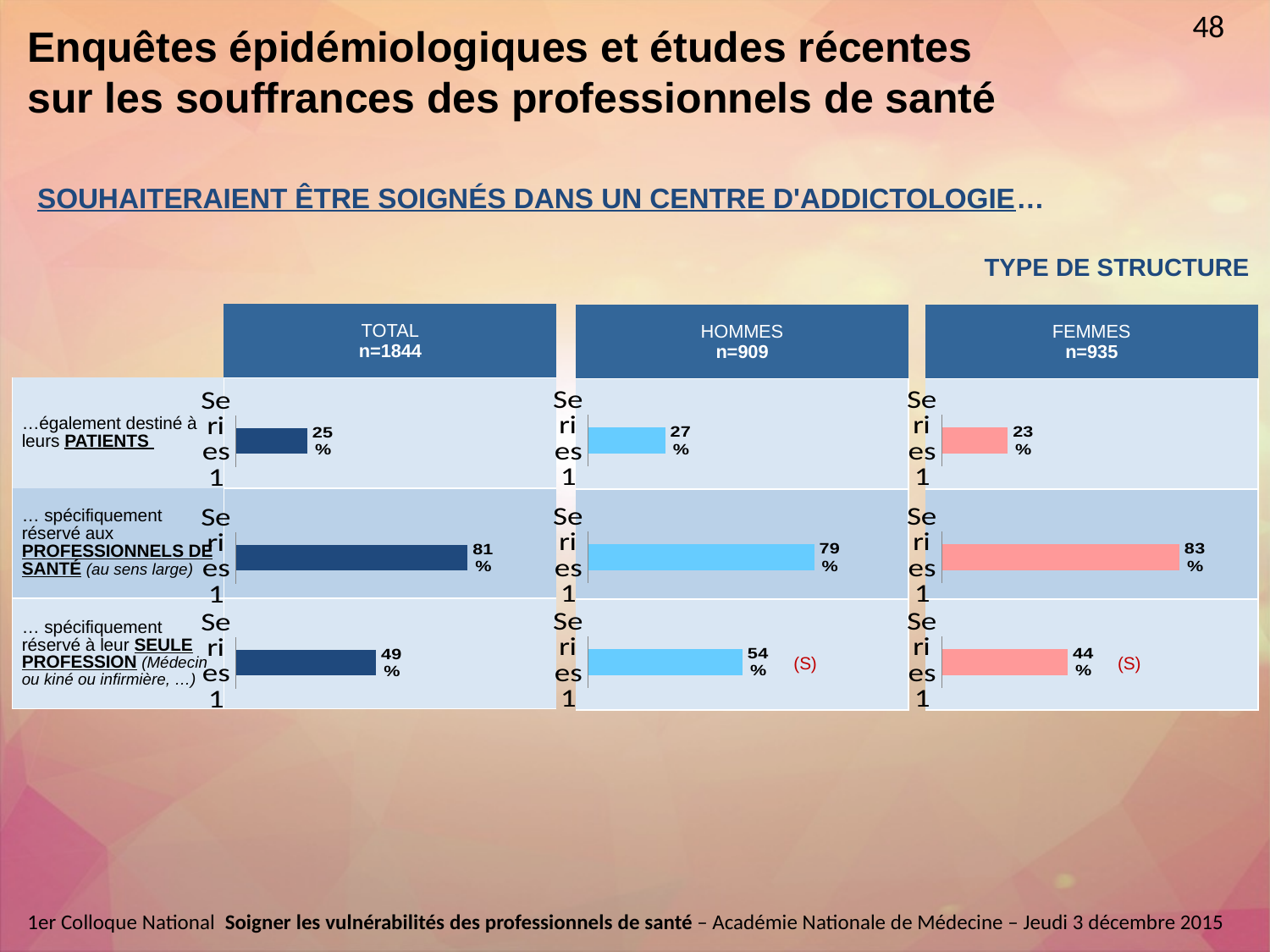
What type of chart is used in each cell of the grid? Bar chart In the HOMMES column, what is the value for the bar in the row '… spécifiquement réservé à leur SEULE PROFESSION'? 54% For the row '… spécifiquement réservé à leur SEULE PROFESSION', what is the difference between the HOMMES value and the FEMMES value? 10% In the FEMMES column, what is the value for the bar in the row '… spécifiquement réservé à leur SEULE PROFESSION'? 44% In the FEMMES column, what is the value for the bar in the row '…également destiné à leurs PATIENTS'? 23% Across the three rows of the FEMMES column, which row has the lowest value? …également destiné à leurs PATIENTS In the TOTAL column, what is the value for the bar in the row '…également destiné à leurs PATIENTS'? 25% For the row '… spécifiquement réservé aux PROFESSIONNELS DE SANTÉ', which is larger: the HOMMES value or the FEMMES value? FEMMES Across the three rows of the TOTAL column, which row has the highest value? … spécifiquement réservé aux PROFESSIONNELS DE SANTÉ In the HOMMES column, what is the value for the bar in the row '… spécifiquement réservé aux PROFESSIONNELS DE SANTÉ'? 79% What is the sample size (n) shown for the HOMMES column? n=909 For the row '…également destiné à leurs PATIENTS', what is the difference between the HOMMES value and the FEMMES value? 4%